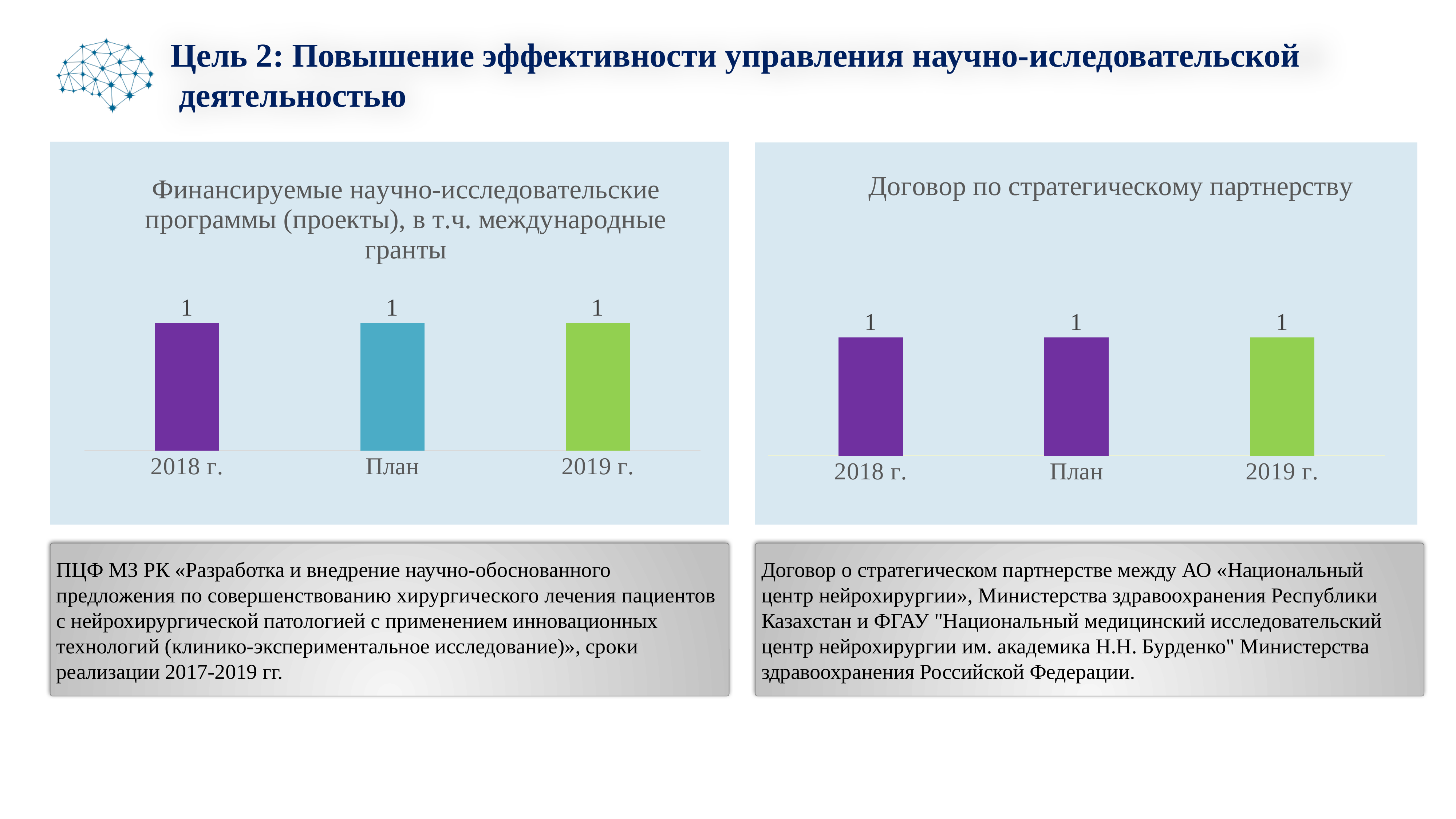
In the right chart (Договор по стратегическому партнерству), what is the value for 2019 г.? 1 What kind of chart is the right chart (Договор по стратегическому партнерству)? Bar chart In the left chart (Финансируемые научно-исследовательские программы), what is the value for 2018 г.? 1 In the left chart (Финансируемые научно-исследовательские программы), what is the difference between the values for 2019 г. and 2018 г.? 0 How many bars does the left chart (Финансируемые научно-исследовательские программы) show? 3 In the left chart (Финансируемые научно-исследовательские программы), do the values rise, fall, or stay the same from 2018 г. to 2019 г.? Stay the same How many categories are on the x axis of the right chart (Договор по стратегическому партнерству)? 3 In the left chart (Финансируемые научно-исследовательские программы), what is the value for План? 1 In the left chart (Финансируемые научно-исследовательские программы), what colour is the План bar? Blue In the right chart (Договор по стратегическому партнерству), is the value for План larger than, smaller than, or equal to the value for 2019 г.? Equal In the right chart (Договор по стратегическому партнерству), what is the value for 2018 г.? 1 What is the title of the right chart on the slide? Договор по стратегическому партнерству